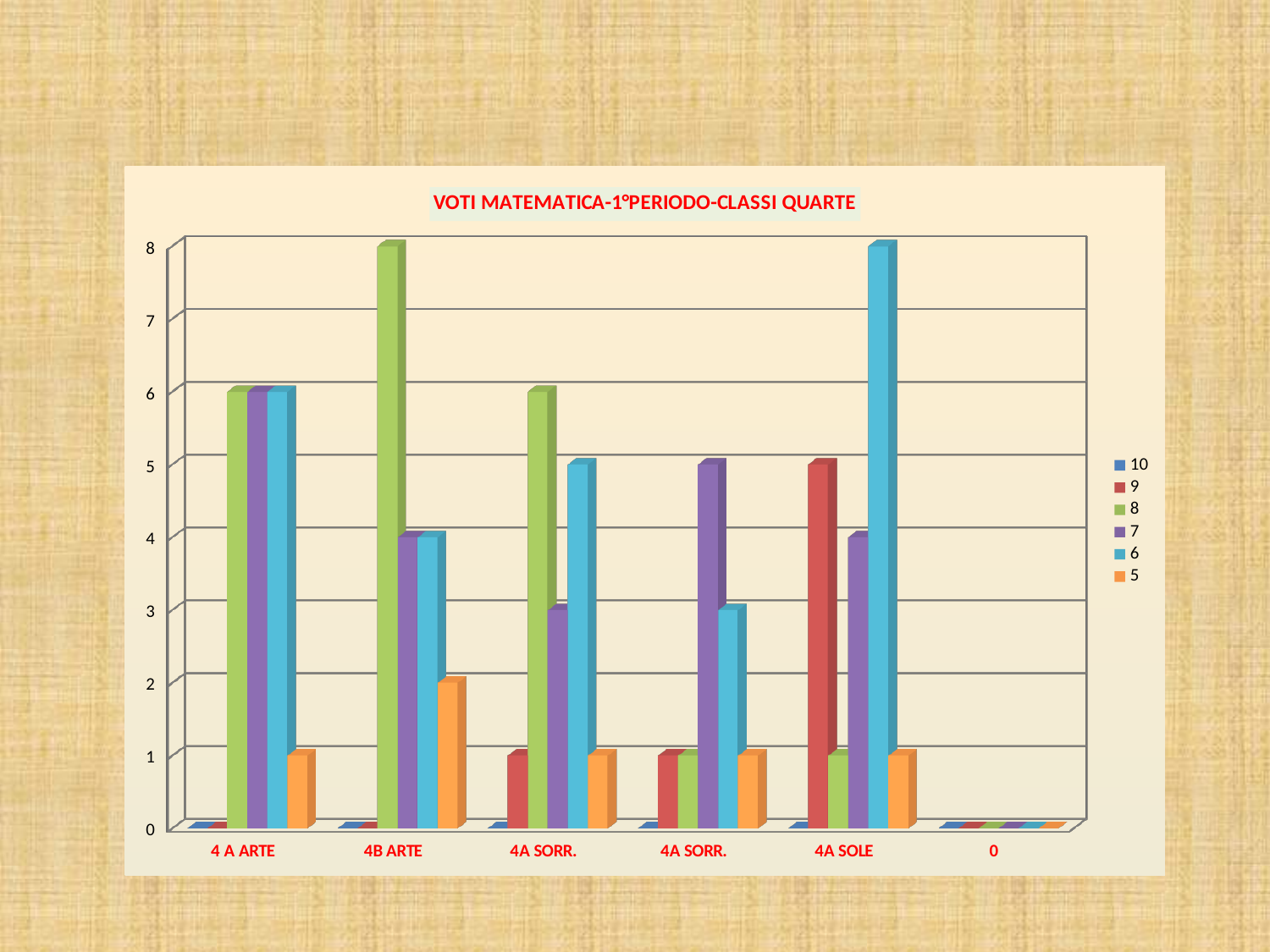
What is the value of series 6 for 4A SOLE? 8 Is the value of series 6 for 4A SOLE greater or less than 5? greater How many series does the legend list? 6 What is the value of series 7 for 4 A ARTE? 6 What is the value of series 8 for 4B ARTE? 8 How many categories are shown on the x axis? 6 What is the value of series 5 for 4B ARTE? 2 For 4B ARTE, what is the difference between the value of series 8 and the value of series 7? 4 What kind of chart is shown on the slide? Bar chart What is the title of the chart? VOTI MATEMATICA-1°PERIODO-CLASSI QUARTE Which category has the highest value for series 8? 4B ARTE Which category has the larger value for series 9: 4A SOLE or 4 A ARTE? 4A SOLE